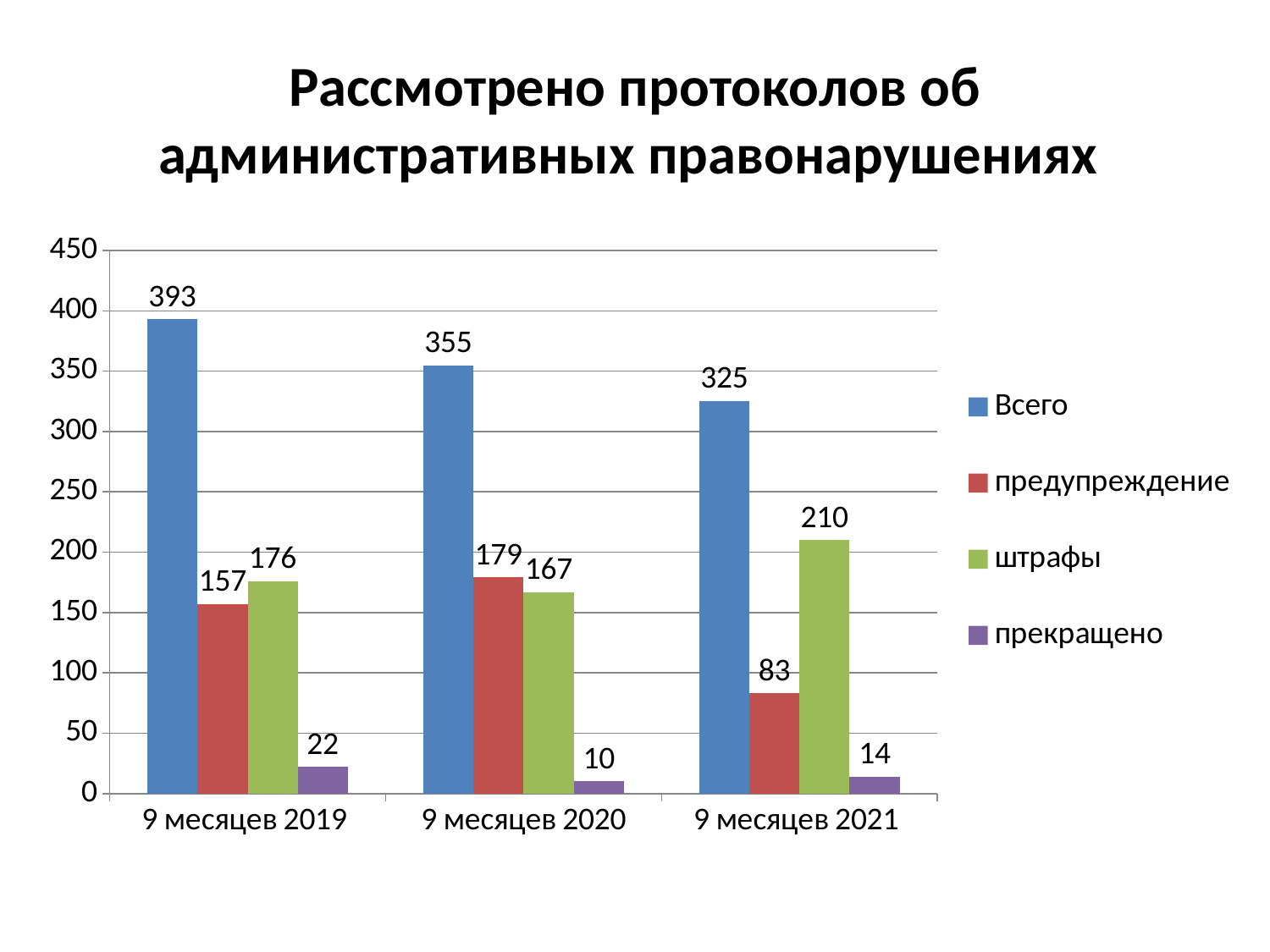
Does the value of Всего rise or fall from 9 месяцев 2019 to 9 месяцев 2021? fall What is the value of предупреждение for 9 месяцев 2020? 179 What is the difference between Всего for 9 месяцев 2019 and Всего for 9 месяцев 2021? 68 What is the value of штрафы for 9 месяцев 2021? 210 What is the value of прекращено for 9 месяцев 2019? 22 Which period has the lowest value for прекращено? 9 месяцев 2020 How many series does the legend list? 4 What kind of chart is shown on the slide? bar chart Which is larger: предупреждение for 9 месяцев 2020 or штрафы for 9 месяцев 2020? предупреждение for 9 месяцев 2020 How many periods are shown on the x axis? 3 Which period has the highest value for Всего? 9 месяцев 2019 What is the value of Всего for 9 месяцев 2019? 393